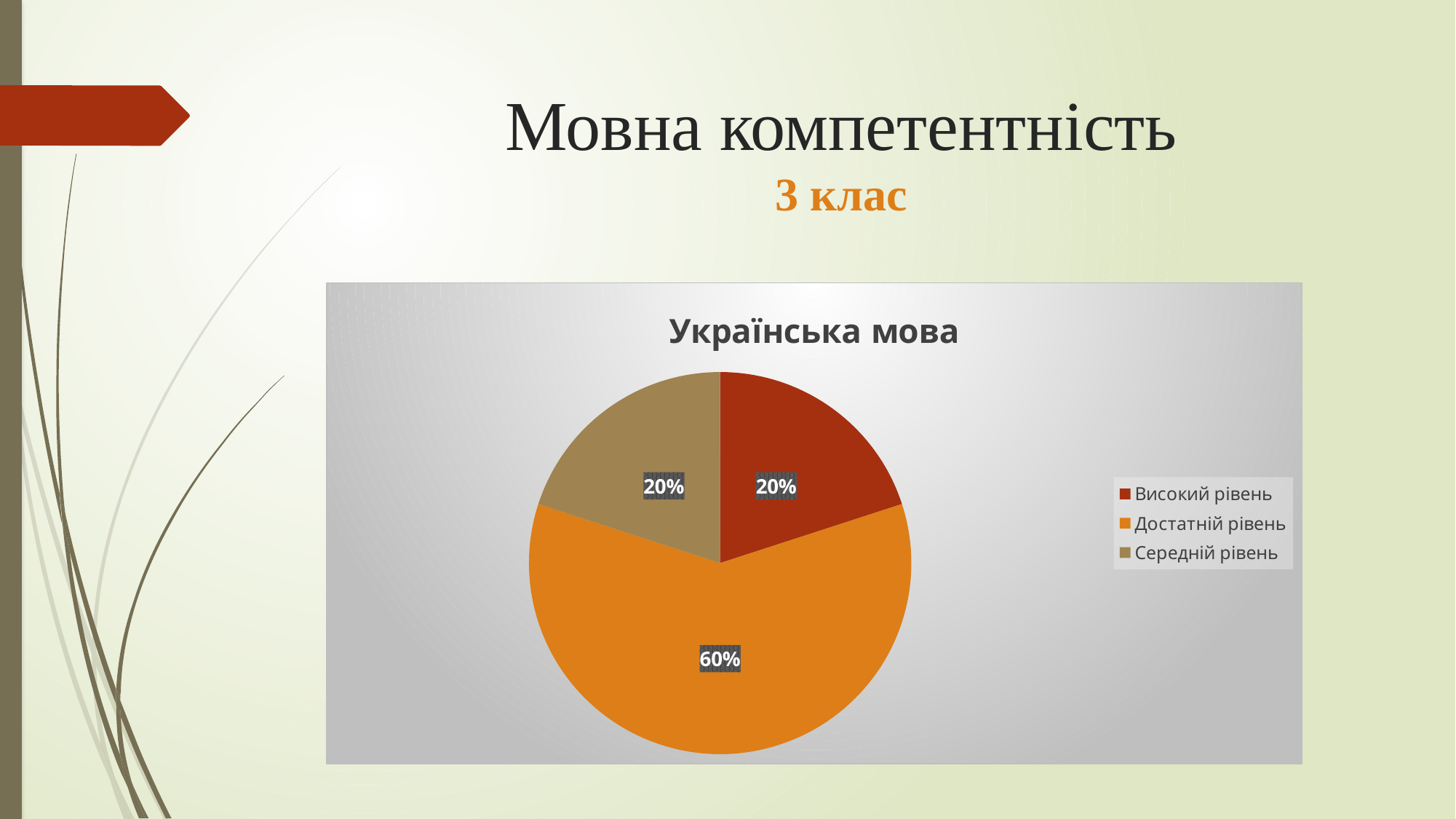
How many entries does the legend list? 3 Which category has the largest slice of the pie? Достатній рівень What kind of chart is shown on the slide? pie chart What share of the pie does Середній рівень have? 20% What is the title of the chart? Українська мова What is the combined share of Високий рівень and Середній рівень? 40% How many slices does the pie chart have? 3 Which is larger, the share for Достатній рівень or the share for Середній рівень? Достатній рівень What colour is the slice for Достатній рівень? orange What is the difference between the share for Достатній рівень and the share for Високий рівень? 40% What share of the pie does Високий рівень have? 20% What share of the pie does Достатній рівень have? 60%